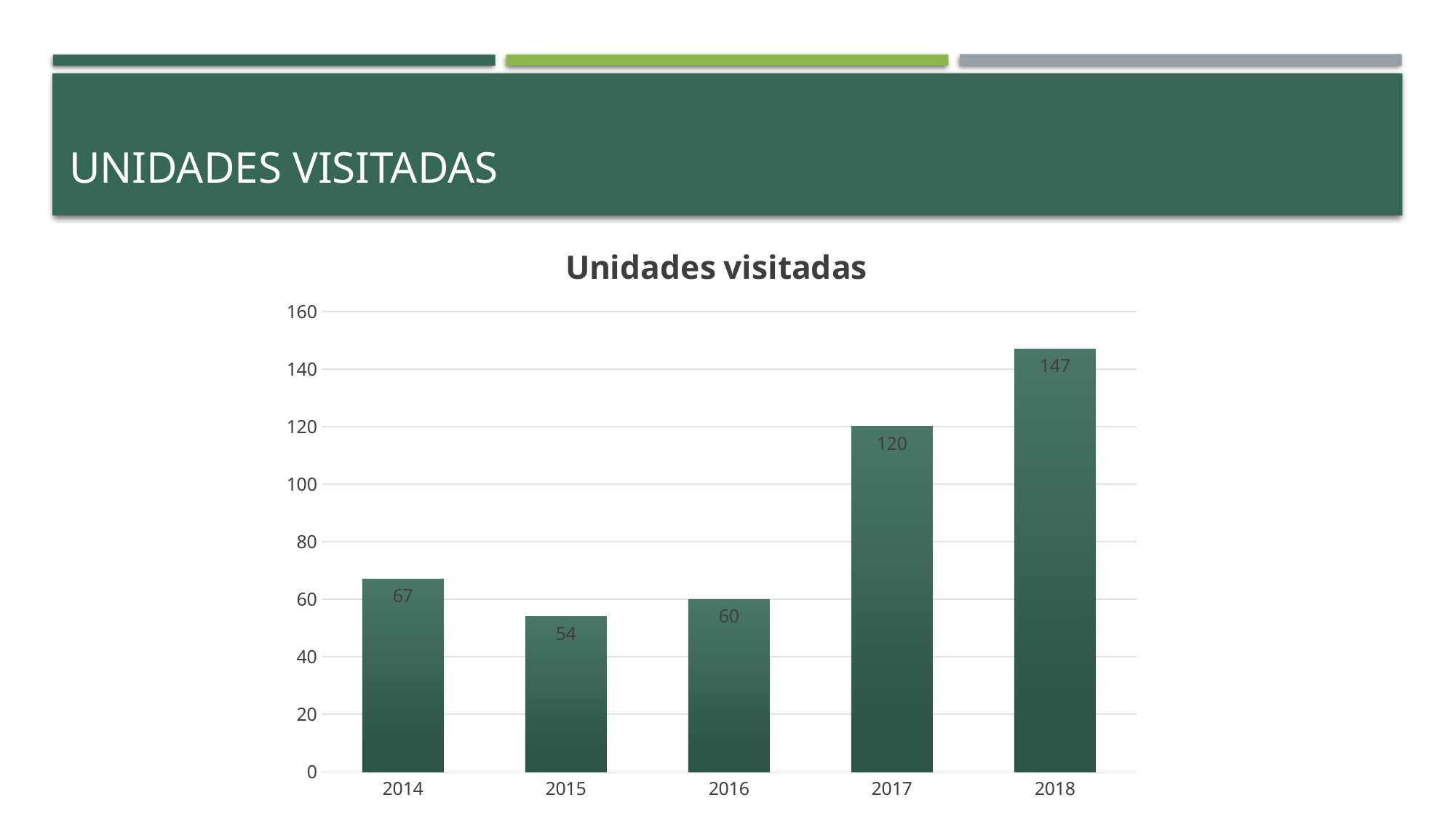
Which is larger, the value for 2016 or the value for 2015? 2016 What is the value for 2014? 67 What is the difference between the values for 2018 and 2017? 27 What is the value for 2015? 54 Which year has the highest value? 2018 How many years are shown on the x axis? 5 What is the value for 2017? 120 What is the difference between the values for 2014 and 2016? 7 Is the value for 2018 greater or less than 140? greater What is the title of the chart? Unidades visitadas What kind of chart is shown on the slide? bar chart Which year has the lowest value? 2015